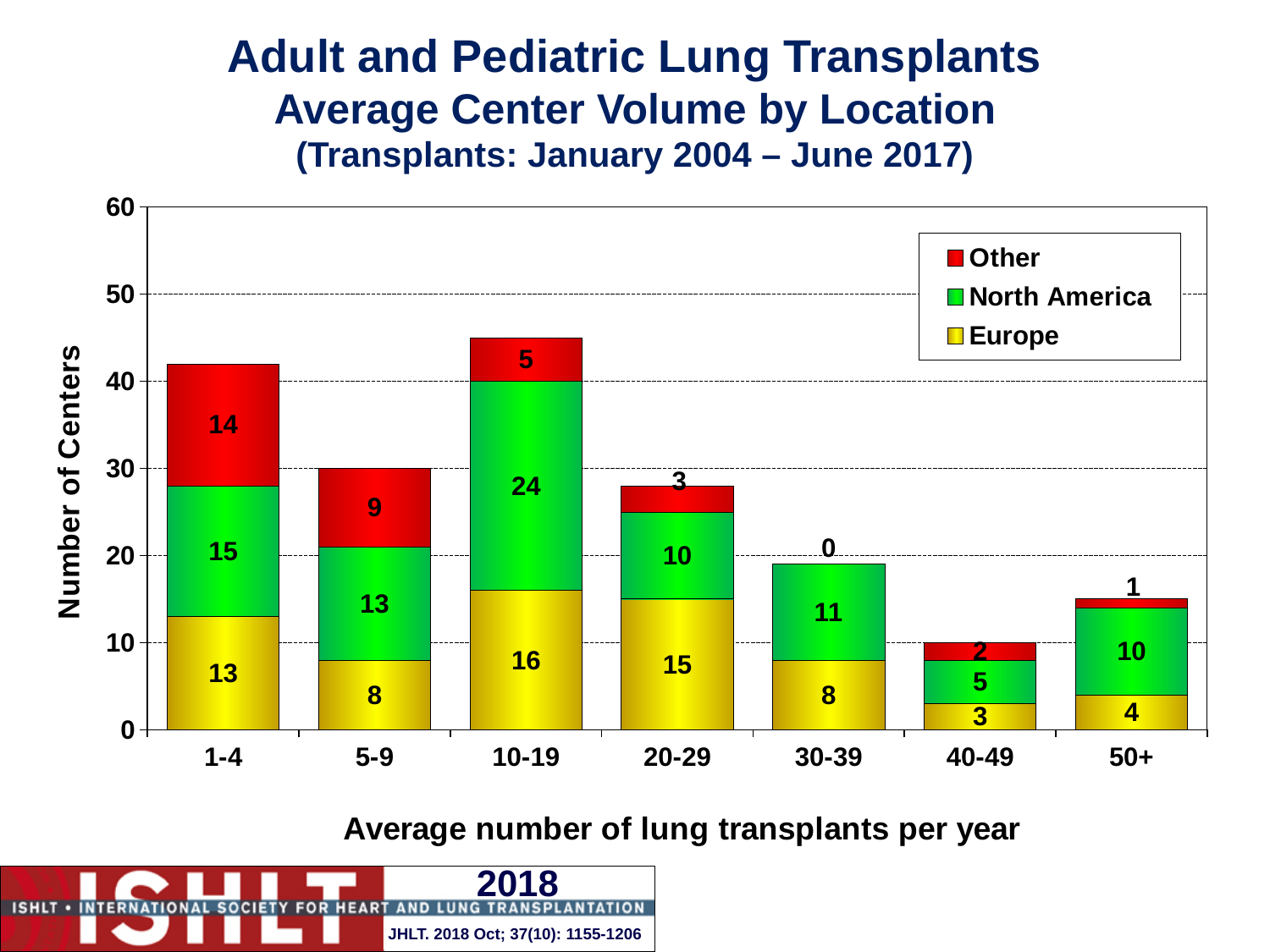
What is the difference between the Europe values for the 10-19 and 5-9 categories? 8 What type of chart is shown on the slide? Stacked bar chart What is the total number of centers in the 1-4 category? 42 How many series does the legend list? 3 Which category has the lowest Europe value? 40-49 Which is larger, the Other value for 5-9 or the Other value for 20-29? 5-9 What is the North America value for the 30-39 category? 11 Which category has the highest North America value? 10-19 How many centers in Europe have an average of 10-19 lung transplants per year? 16 What is the total number of centers in the 40-49 category? 10 What is the Other value for the 1-4 category? 14 How many categories are shown on the x axis? 7